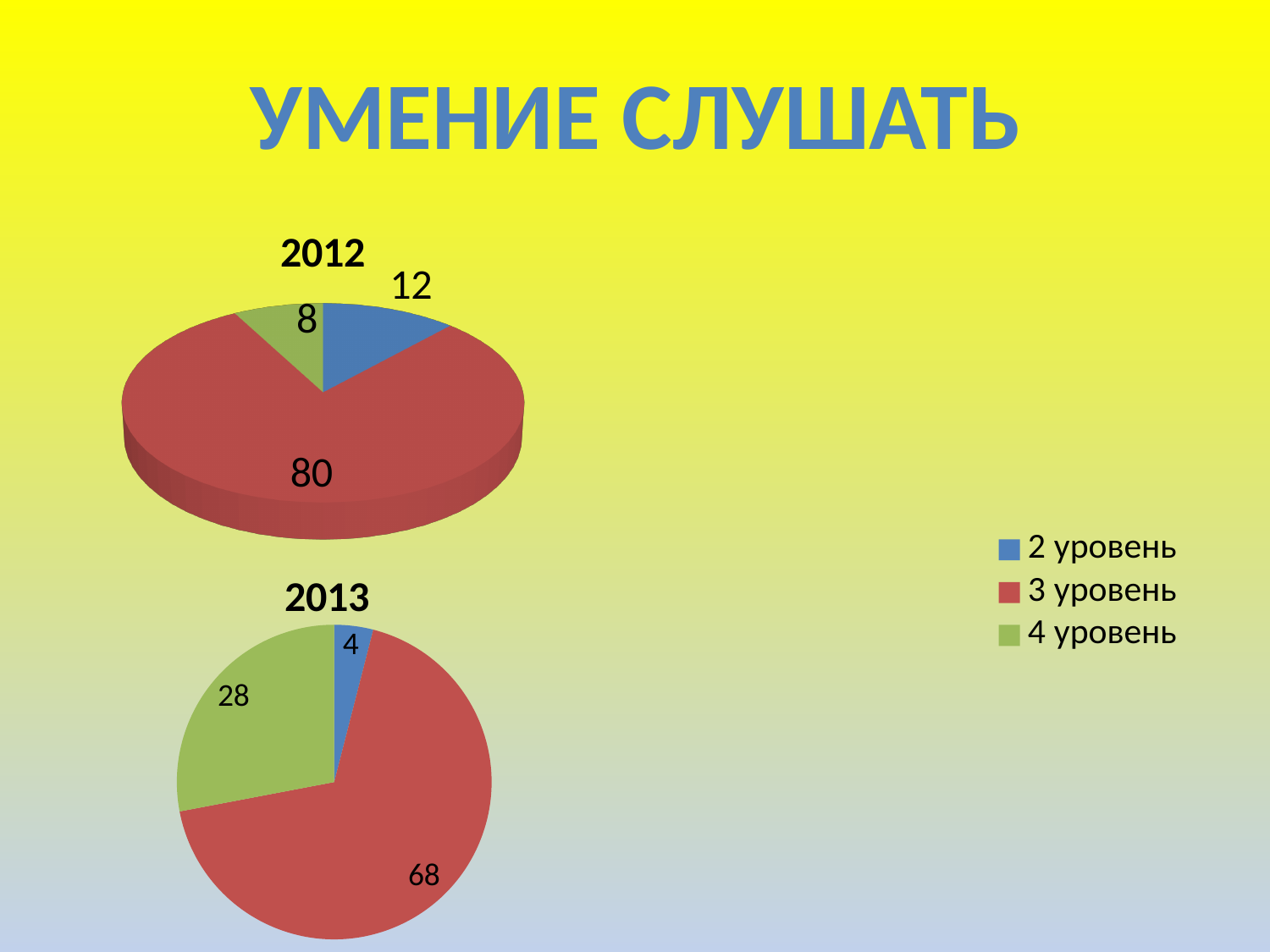
How many entries does the legend list? 3 What kind of chart is the 2012 chart? Pie chart In the 2013 chart, what is the value for 4 уровень? 28 In the 2013 chart, what is the value for 2 уровень? 4 In the 2013 chart, what is the difference between the values for 3 уровень and 4 уровень? 40 How many slices does the 2013 chart have? 3 In the 2012 chart, which category has the largest slice? 3 уровень In the 2012 chart, what is the value for 2 уровень? 12 In the 2013 chart, what share of the total does 3 уровень represent? 68% In the 2012 chart, which is larger: the value for 2 уровень or the value for 4 уровень? 2 уровень In the 2012 chart, what is the value for 3 уровень? 80 In the 2013 chart, which category has the smallest slice? 2 уровень